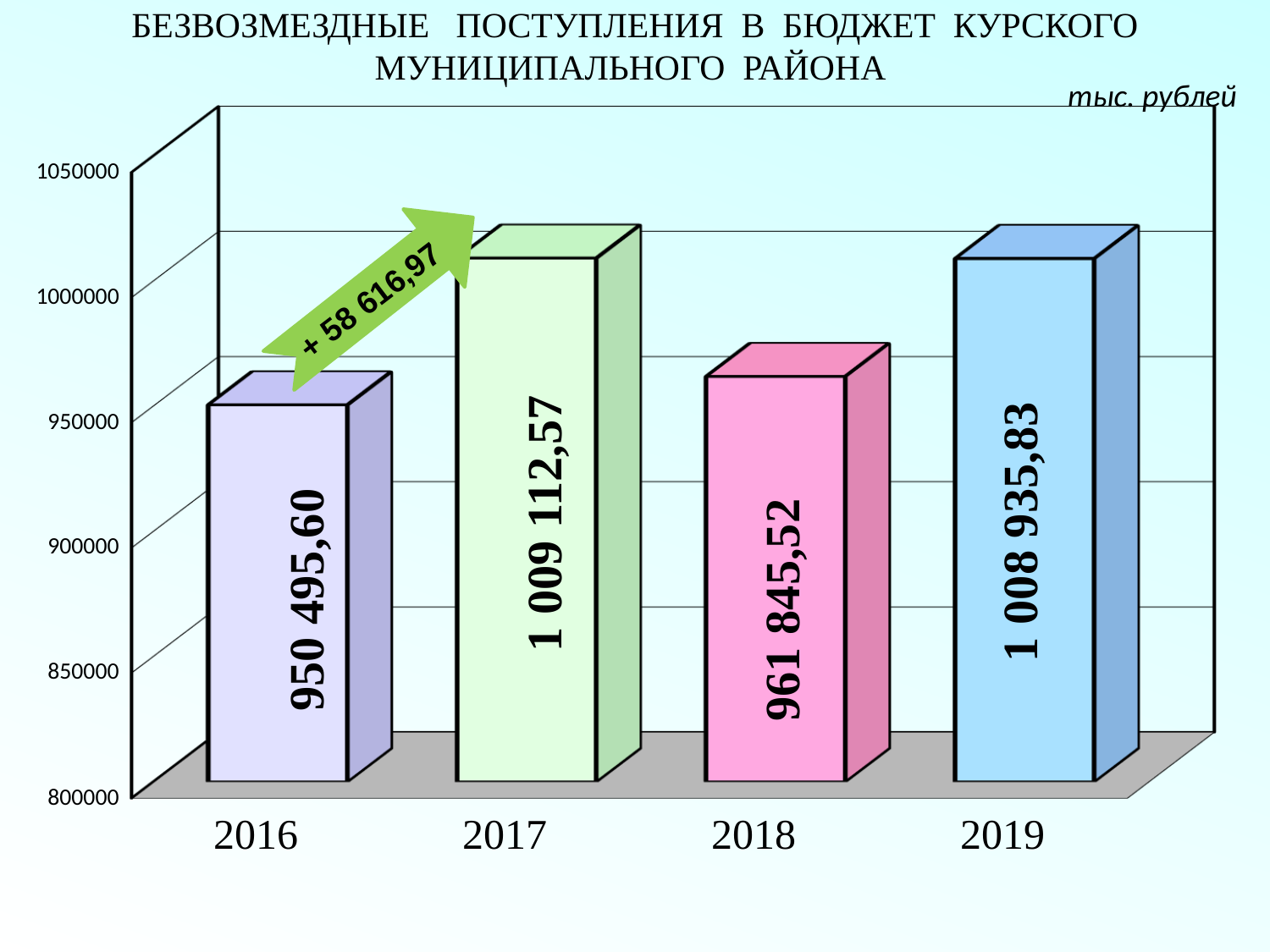
What is the value for 2018? 961 845,52 By how much did the value increase from 2016 to 2017? 58 616,97 Is the value for 2018 greater or less than 1000000? less What is the value for 2016? 950 495,60 Which year has the lowest value? 2016 What unit of measurement is indicated on the slide? тыс. рублей Which year has the highest value? 2017 What is the difference between the values for 2019 and 2018? 47 090,31 What is the value for 2019? 1 008 935,83 Which is larger, the value for 2018 or the value for 2016? 2018 What is the value for 2017? 1 009 112,57 How many years are shown on the chart? 4